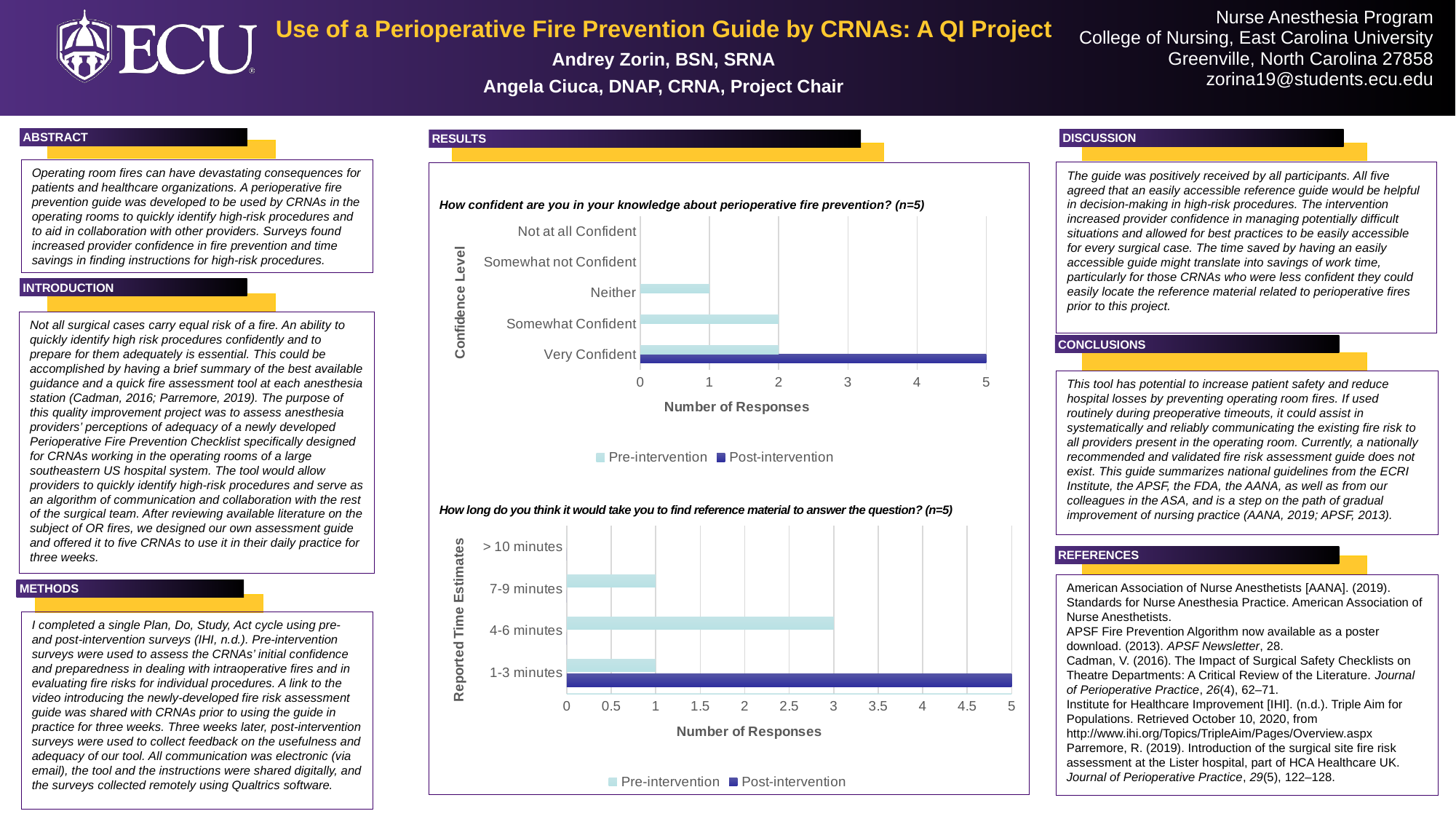
In the chart titled "How confident are you in your knowledge about perioperative fire prevention? (n=5)", how many series does the legend list? 2 In the chart titled "How long do you think it would take you to find reference material to answer the question? (n=5)", which time estimate has the highest Pre-intervention number of responses? 4-6 minutes In the chart titled "How confident are you in your knowledge about perioperative fire prevention? (n=5)", what is the Pre-intervention number of responses for Neither? 1 In the chart titled "How confident are you in your knowledge about perioperative fire prevention? (n=5)", how many confidence level categories are shown on the y axis? 5 In the chart titled "How confident are you in your knowledge about perioperative fire prevention? (n=5)", what is the difference between the Post-intervention and Pre-intervention responses for Very Confident? 3 In the chart titled "How long do you think it would take you to find reference material to answer the question? (n=5)", what is the label of the x axis? Number of Responses In the chart titled "How confident are you in your knowledge about perioperative fire prevention? (n=5)", what is the Pre-intervention number of responses for Somewhat Confident? 2 In the chart titled "How long do you think it would take you to find reference material to answer the question? (n=5)", what is the Pre-intervention number of responses for 4-6 minutes? 3 In the chart titled "How long do you think it would take you to find reference material to answer the question? (n=5)", what is the Post-intervention number of responses for 1-3 minutes? 5 What kind of chart is the one titled "How long do you think it would take you to find reference material to answer the question? (n=5)"? Bar chart In the chart titled "How long do you think it would take you to find reference material to answer the question? (n=5)", which is larger for 1-3 minutes: the Pre-intervention or Post-intervention number of responses? Post-intervention In the chart titled "How confident are you in your knowledge about perioperative fire prevention? (n=5)", what is the Post-intervention number of responses for Very Confident? 5